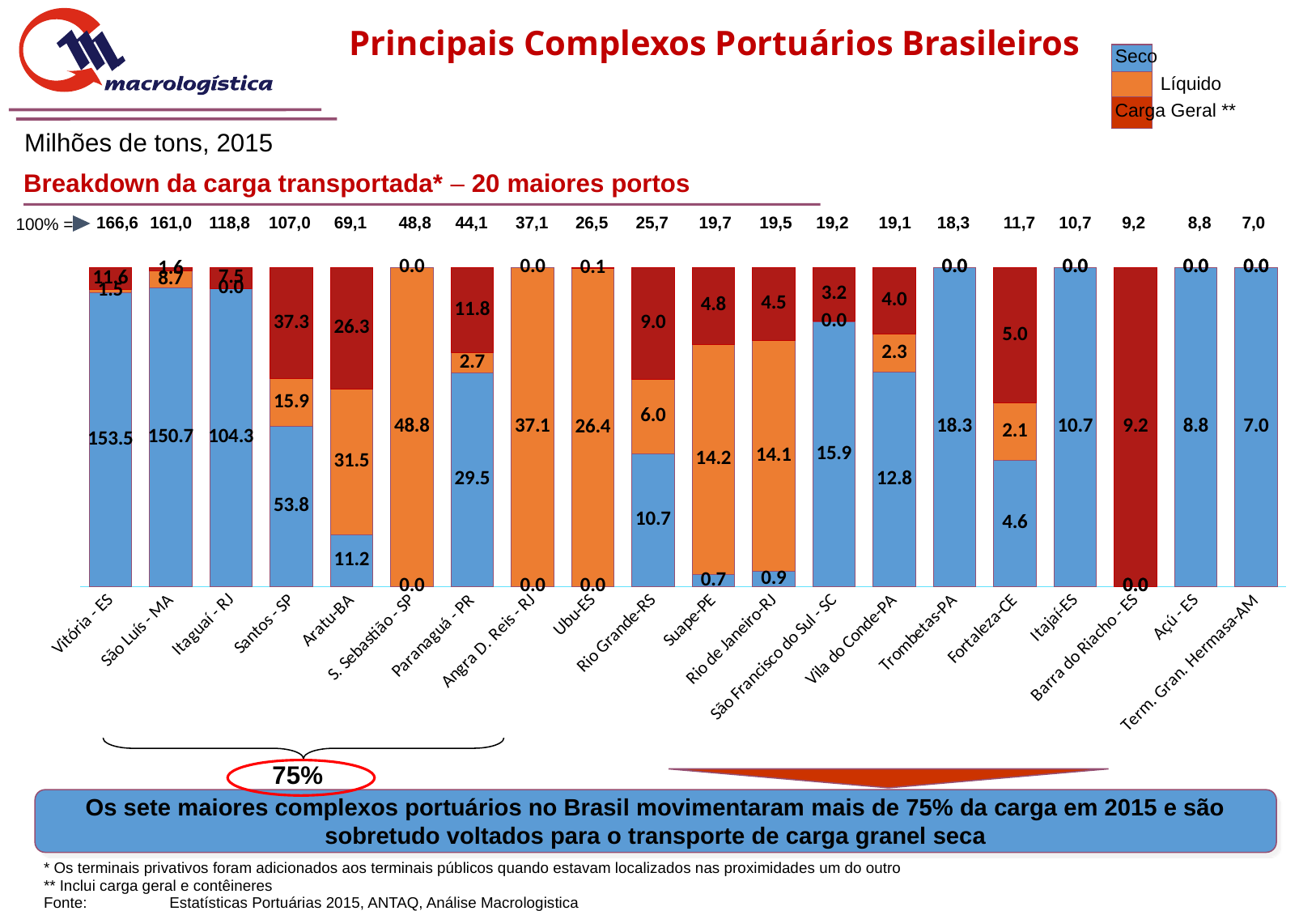
Which is larger, the Carga Geral value for Santos - SP or for Aratu-BA? Santos - SP What is the Carga Geral value for Paranaguá - PR? 11.8 What is the Líquido value for Aratu-BA? 31.5 Which series is shown in blue in the legend? Seco What kind of chart is shown on the slide? Stacked bar chart What is the difference between the Seco values of Vitória - ES and São Luís - MA? 2.8 Which port has the lowest total cargo shown above the bars? Term. Gran. Hermasa-AM How many ports are shown on the x axis of the chart? 20 What is the Seco (dry bulk) value for Santos - SP? 53.8 Which port has the highest total cargo shown above the bars? Vitória - ES How many series does the legend list? 3 What is the total cargo (in millions of tons) shown above the bar for Vitória - ES? 166,6